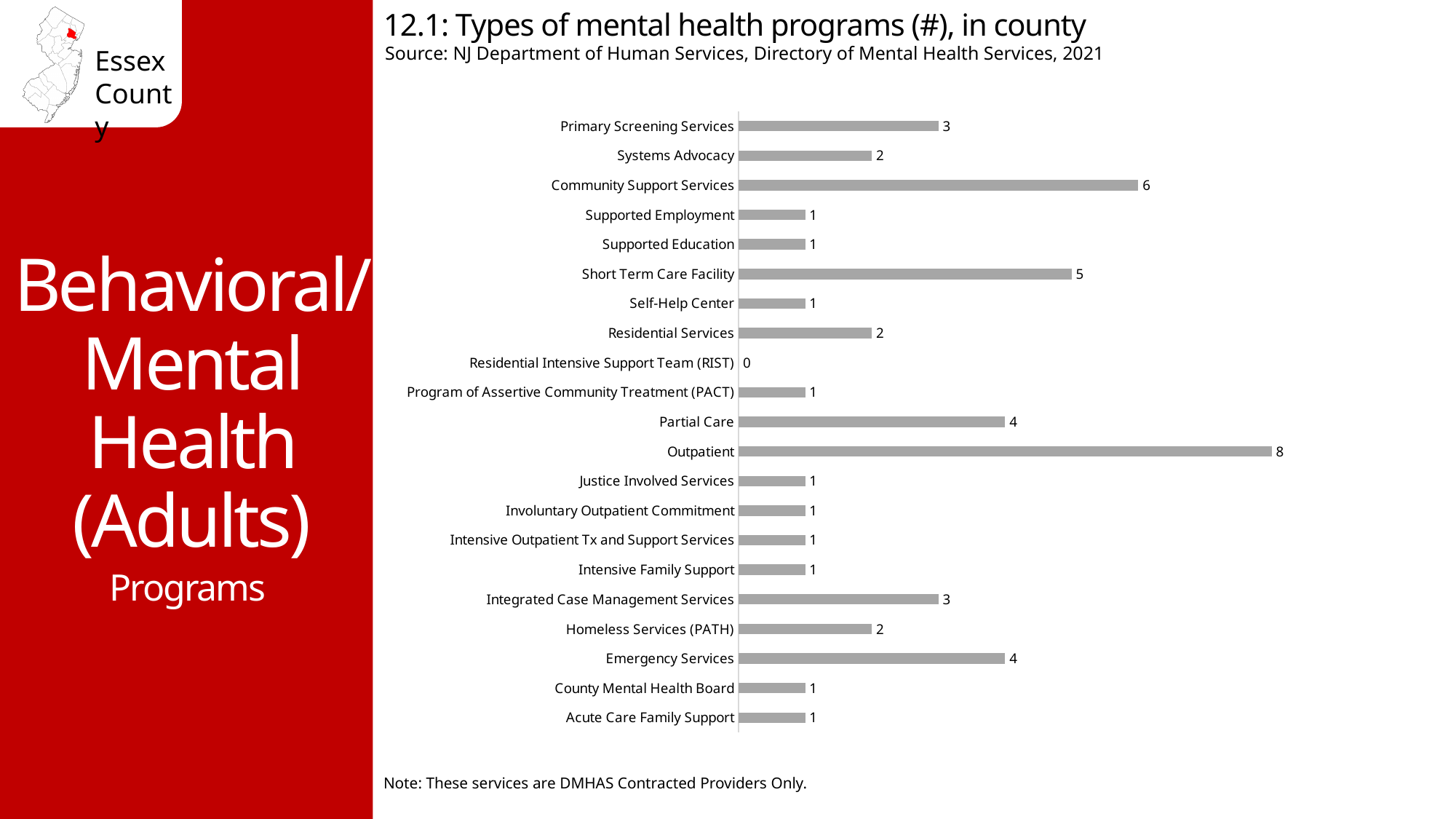
What is the value for Outpatient? 8 What is the difference between the values for Outpatient and Partial Care? 4 Which program type has the lowest number of programs? Residential Intensive Support Team (RIST) What is the value for Residential Intensive Support Team (RIST)? 0 What is the title of the chart? 12.1: Types of mental health programs (#), in county Which program type has the highest number of programs? Outpatient Which is larger, the value for Emergency Services or the value for Integrated Case Management Services? Emergency Services What is the difference between the values for Community Support Services and Homeless Services (PATH)? 4 How many program types are shown in the chart? 21 What is the value for Community Support Services? 6 What is the value for Short Term Care Facility? 5 What kind of chart is shown on the slide? Bar chart